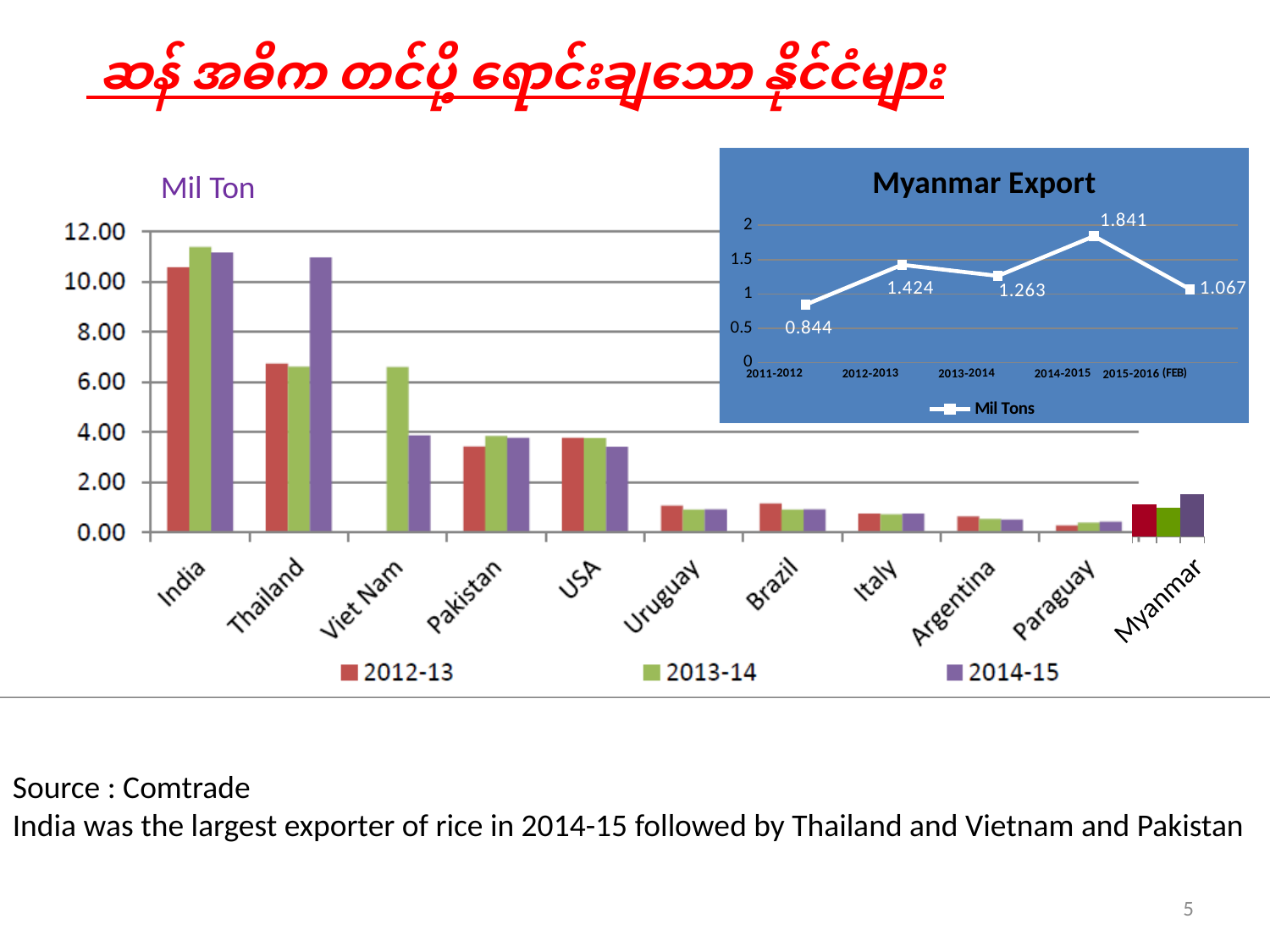
In the Myanmar Export chart, what was the export value for 2011-2012? 0.844 In the Myanmar Export chart, how many data points are plotted? 5 In the Myanmar Export chart, what was the export value for 2014-2015? 1.841 In the large rice exporters bar chart, how many countries are shown on the x axis? 11 In the large rice exporters bar chart, how many series does the legend list? 3 In the large rice exporters bar chart, which country has the highest 2014-15 value? India In the Myanmar Export chart, which year had the lowest export value? 2011-2012 In the Myanmar Export chart, which year had the highest export value? 2014-2015 In the Myanmar Export chart, what is the difference between the 2014-2015 value and the 2015-2016 (FEB) value? 0.774 In the large rice exporters bar chart, is the 2014-15 value for Thailand greater or less than 10.00? greater In the Myanmar Export chart, which is larger: the value for 2012-2013 or the value for 2013-2014? 2012-2013 What kind of chart is the Myanmar Export chart? Line chart